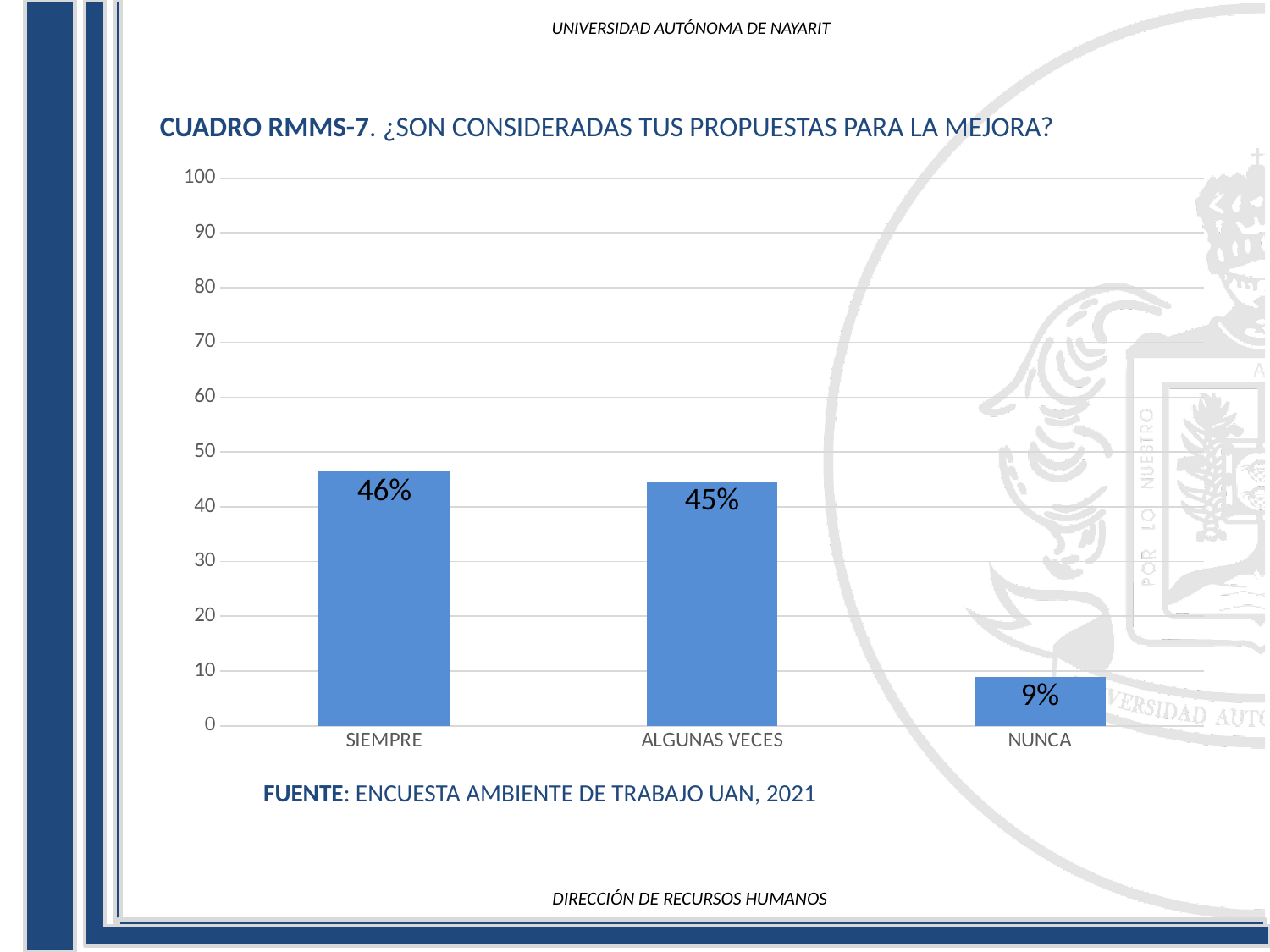
What source is cited below the chart? ENCUESTA AMBIENTE DE TRABAJO UAN, 2021 What is the value for ALGUNAS VECES? 45% Which is larger, the value for ALGUNAS VECES or the value for NUNCA? ALGUNAS VECES How many categories are shown on the x axis? 3 What is the value for NUNCA? 9% What is the difference between the values for SIEMPRE and NUNCA? 37% What is the difference between the values for ALGUNAS VECES and NUNCA? 36% Is the value for NUNCA greater or less than 20? less Is the value for SIEMPRE greater or less than 50? less What is the value for SIEMPRE? 46% What kind of chart is shown on the slide? bar chart Which category has the lowest value? NUNCA